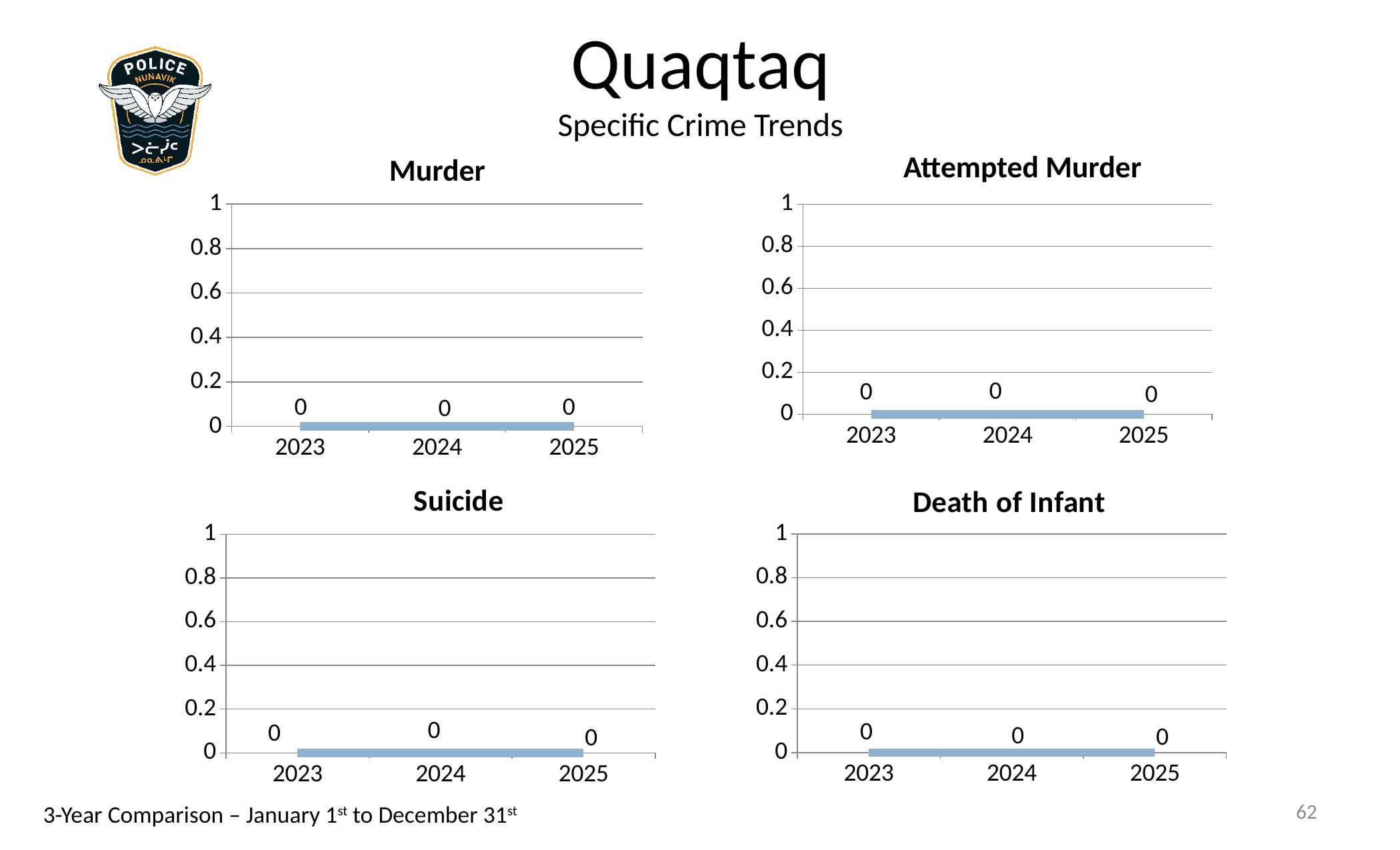
In the Murder chart, what is the value for 2023? 0 In the Suicide chart, do the values rise, fall, or stay the same from 2023 to 2025? stay the same In the Death of Infant chart, how many categories are plotted? 3 In the Attempted Murder chart, what is the value for 2024? 0 In the Death of Infant chart, what is the value for 2023? 0 What is the title of the chart in the bottom-right of the slide? Death of Infant In the Murder chart, is the value for 2024 greater or less than 0.2? less In the Murder chart, how many years are shown on the x axis? 3 In the Attempted Murder chart, what is the difference between the values for 2023 and 2025? 0 What kind of chart is the Suicide chart? line chart What is the highest value shown on the y axis of the Attempted Murder chart? 1 In the Suicide chart, what is the value for 2025? 0